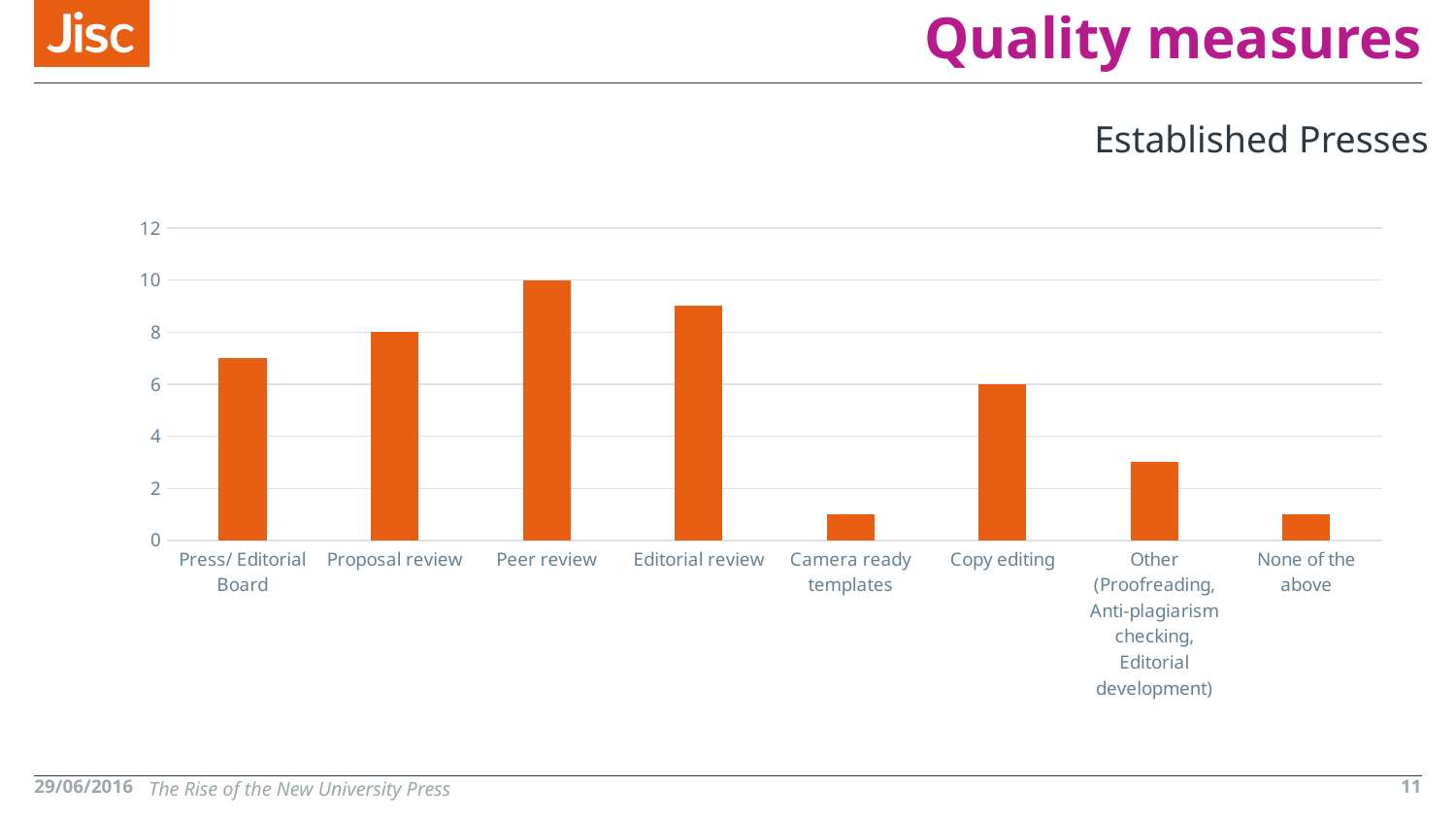
What is the value for Peer review? 10 How many categories are shown on the x axis of the chart? 8 Which category has the highest value in the chart? Peer review Is the value for Press/ Editorial Board greater or less than 6? greater What is the value for Proposal review? 8 What type of chart is shown on the slide? bar chart What is the difference between the values for Peer review and Copy editing? 4 Is the value for Editorial review greater or less than 8? greater Is the value for Camera ready templates greater or less than 2? less What is the subtitle shown above the chart? Established Presses Which is larger, the value for Editorial review or the value for Copy editing? Editorial review What is the value for Copy editing? 6